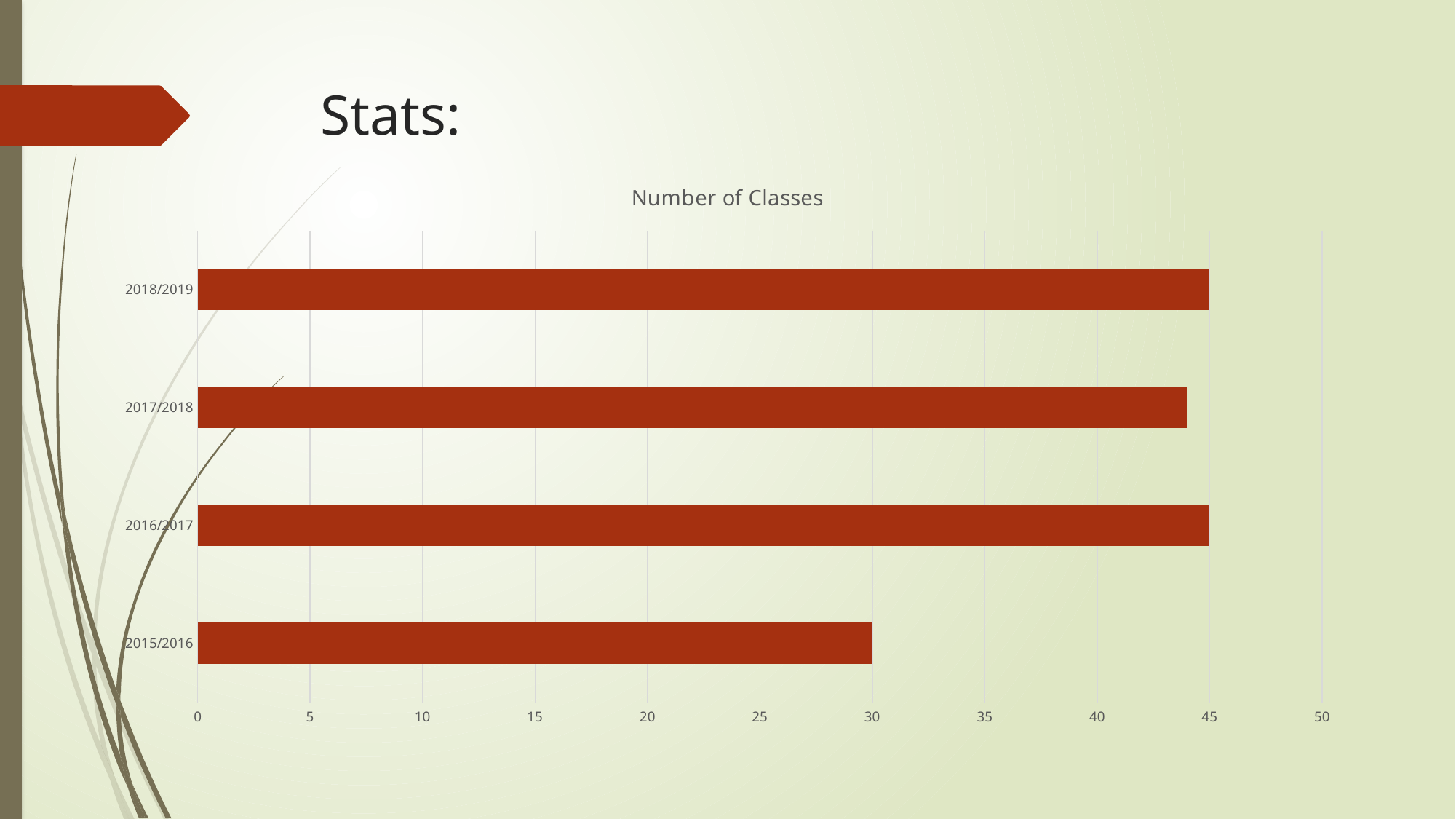
What is the number of classes for 2015/2016? 30 What is the number of classes for 2018/2019? 45 Is the value for 2017/2018 greater or less than 40? greater Which academic year has the lowest number of classes? 2015/2016 What colour are the bars in the chart? dark red Which has more classes, 2015/2016 or 2017/2018? 2017/2018 What is the title of the chart? Number of Classes How many categories (academic years) are shown in the chart? 4 What kind of chart is shown on the slide? bar chart Is the value for 2015/2016 greater or less than 35? less What is the difference in number of classes between 2018/2019 and 2015/2016? 15 What is the number of classes for 2016/2017? 45